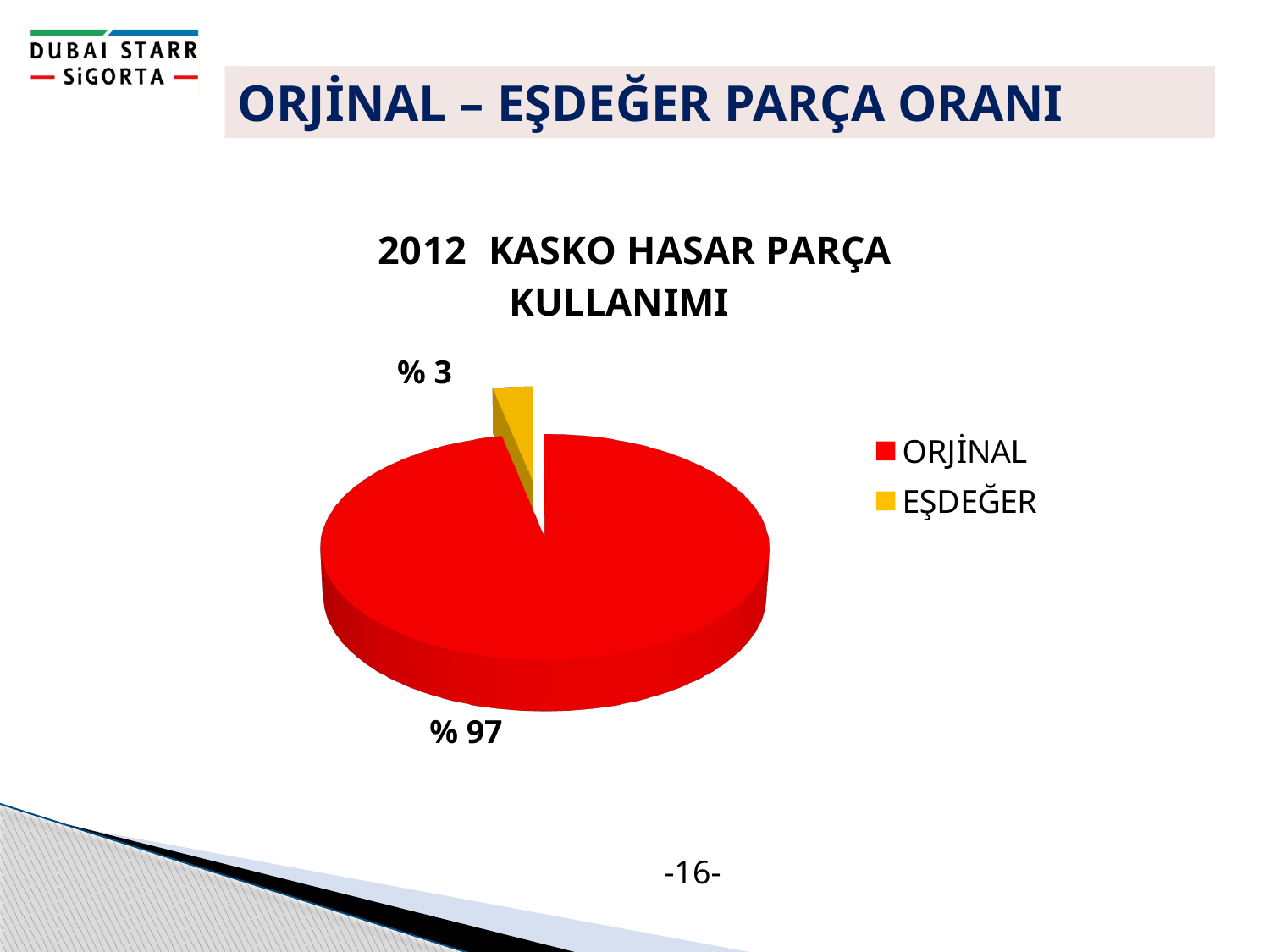
What is the difference in percentage points between the ORJİNAL and EŞDEĞER slices? 94 Which is larger, the ORJİNAL slice or the EŞDEĞER slice? ORJİNAL What type of chart is shown on the slide? pie chart Which category has the largest slice of the pie? ORJİNAL What share of the pie does EŞDEĞER represent? % 3 Which category has the smallest slice of the pie? EŞDEĞER How many categories does the pie chart show? 2 What colour is the EŞDEĞER slice in the pie chart? yellow How many entries does the legend list? 2 What share of the pie does ORJİNAL represent? % 97 What is the title of the chart? 2012 KASKO HASAR PARÇA KULLANIMI